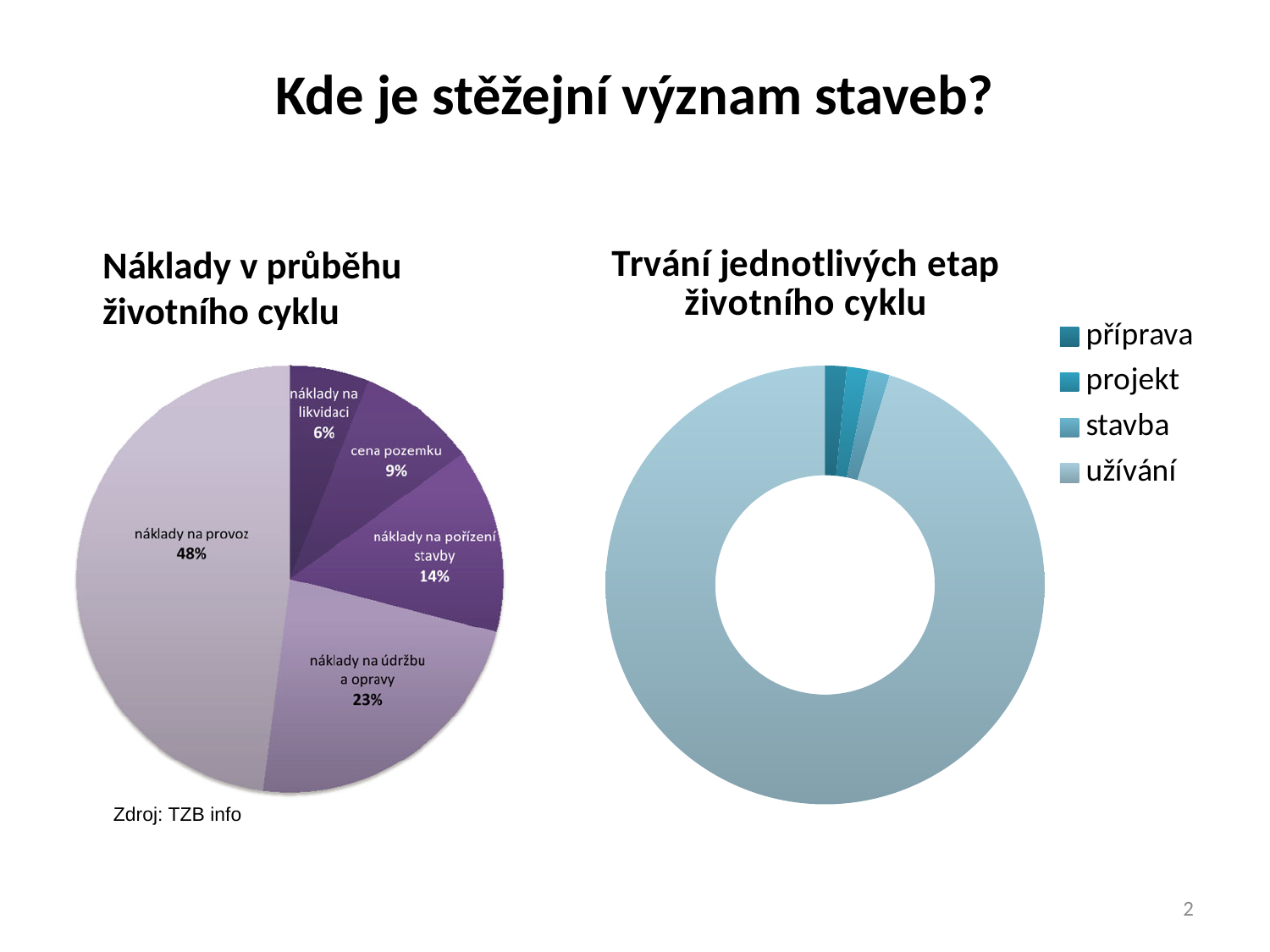
In the chart 'Náklady v průběhu životního cyklu', what share is labelled for 'náklady na likvidaci'? 6% In the chart 'Trvání jednotlivých etap životního cyklu', which category takes up the largest part of the ring? užívání In the chart 'Náklady v průběhu životního cyklu', what share is labelled for 'cena pozemku'? 9% In the chart 'Náklady v průběhu životního cyklu', what share is labelled for 'náklady na údržbu a opravy'? 23% How many entries does the legend of the chart 'Trvání jednotlivých etap životního cyklu' list? 4 In the chart 'Náklady v průběhu životního cyklu', what is the difference in percentage points between 'náklady na provoz' and 'náklady na údržbu a opravy'? 25 In the chart 'Náklady v průběhu životního cyklu', which is larger: 'náklady na pořízení stavby' or 'cena pozemku'? náklady na pořízení stavby How many categories are shown in the chart 'Náklady v průběhu životního cyklu'? 5 In the chart 'Náklady v průběhu životního cyklu', what share is labelled for 'náklady na provoz'? 48% In the chart 'Náklady v průběhu životního cyklu', which category has the smallest share? náklady na likvidaci What kind of chart is 'Trvání jednotlivých etap životního cyklu'? doughnut chart In the chart 'Náklady v průběhu životního cyklu', which category has the largest share? náklady na provoz